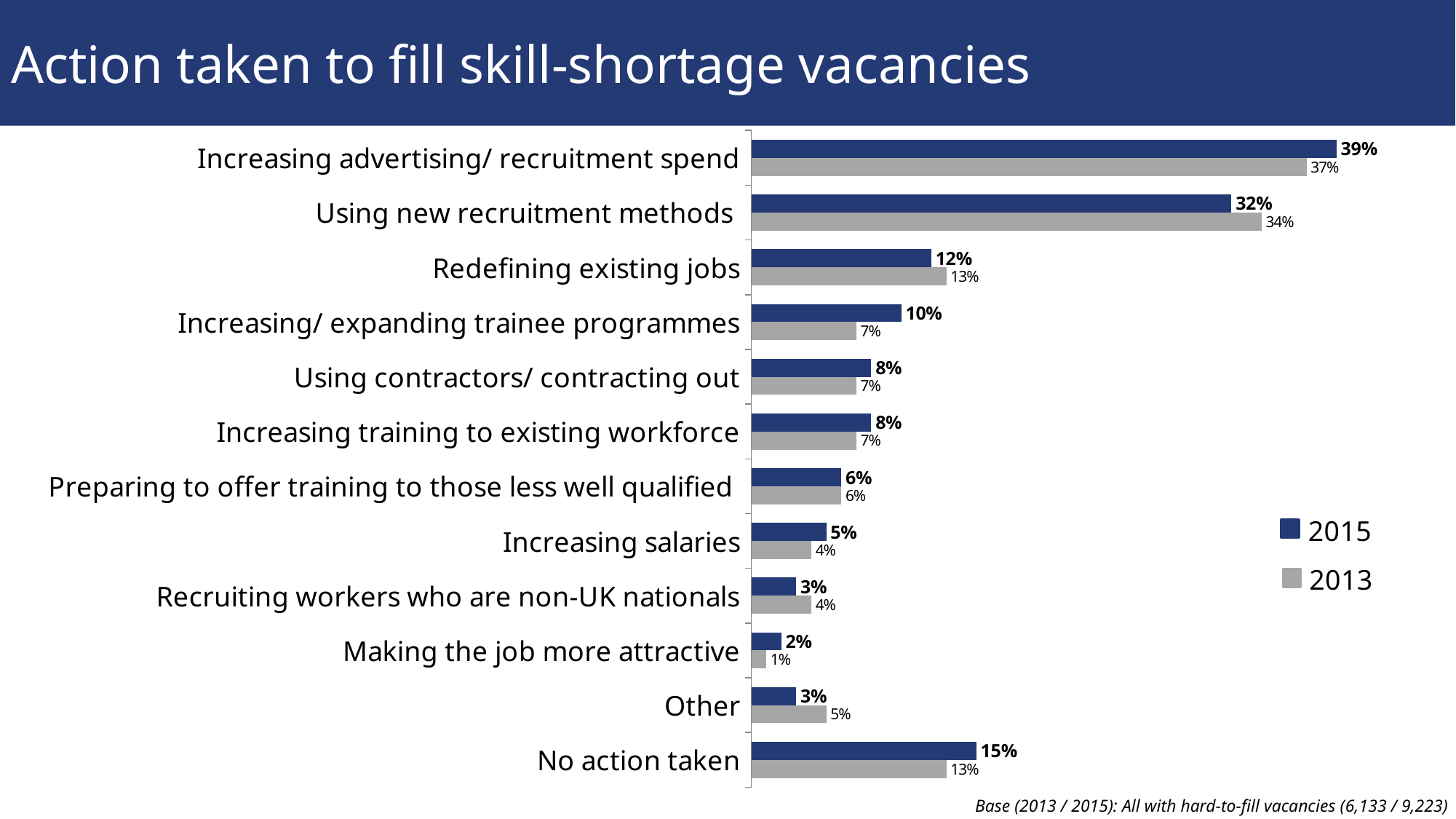
What is the 2015 value for No action taken? 15% What is the 2015 value for Increasing advertising/ recruitment spend? 39% How many series does the legend list? 2 Which category has the highest 2015 value? Increasing advertising/ recruitment spend What kind of chart is shown on the slide? Bar chart What is the 2013 value for Using new recruitment methods? 34% What is the title of the chart? Action taken to fill skill-shortage vacancies Which is larger for Other: the 2015 value or the 2013 value? 2013 Which category has the lowest 2013 value? Making the job more attractive Which colour represents the 2013 series? Grey What is the difference between the 2015 and 2013 values for Increasing/ expanding trainee programmes? 3% How many categories are shown on the chart? 12